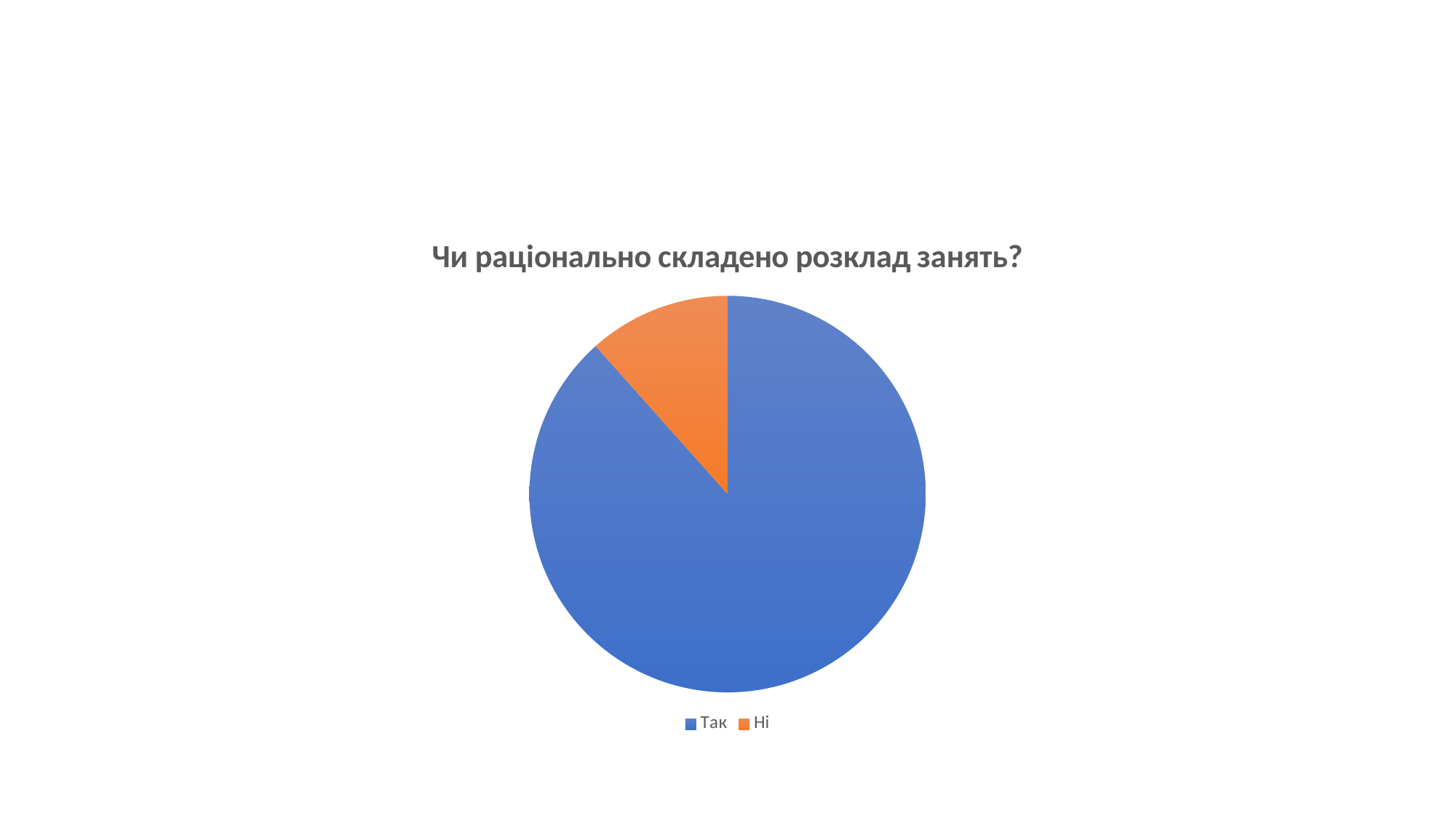
What kind of chart is shown on the slide? pie chart Which category has the smallest slice of the pie? Ні Which category has the largest slice of the pie? Так How many entries does the legend list? 2 What colour is the slice for Ні? orange What is the title of the chart? Чи раціонально складено розклад занять? How many slices does the pie chart have? 2 Which slice is larger, Так or Ні? Так